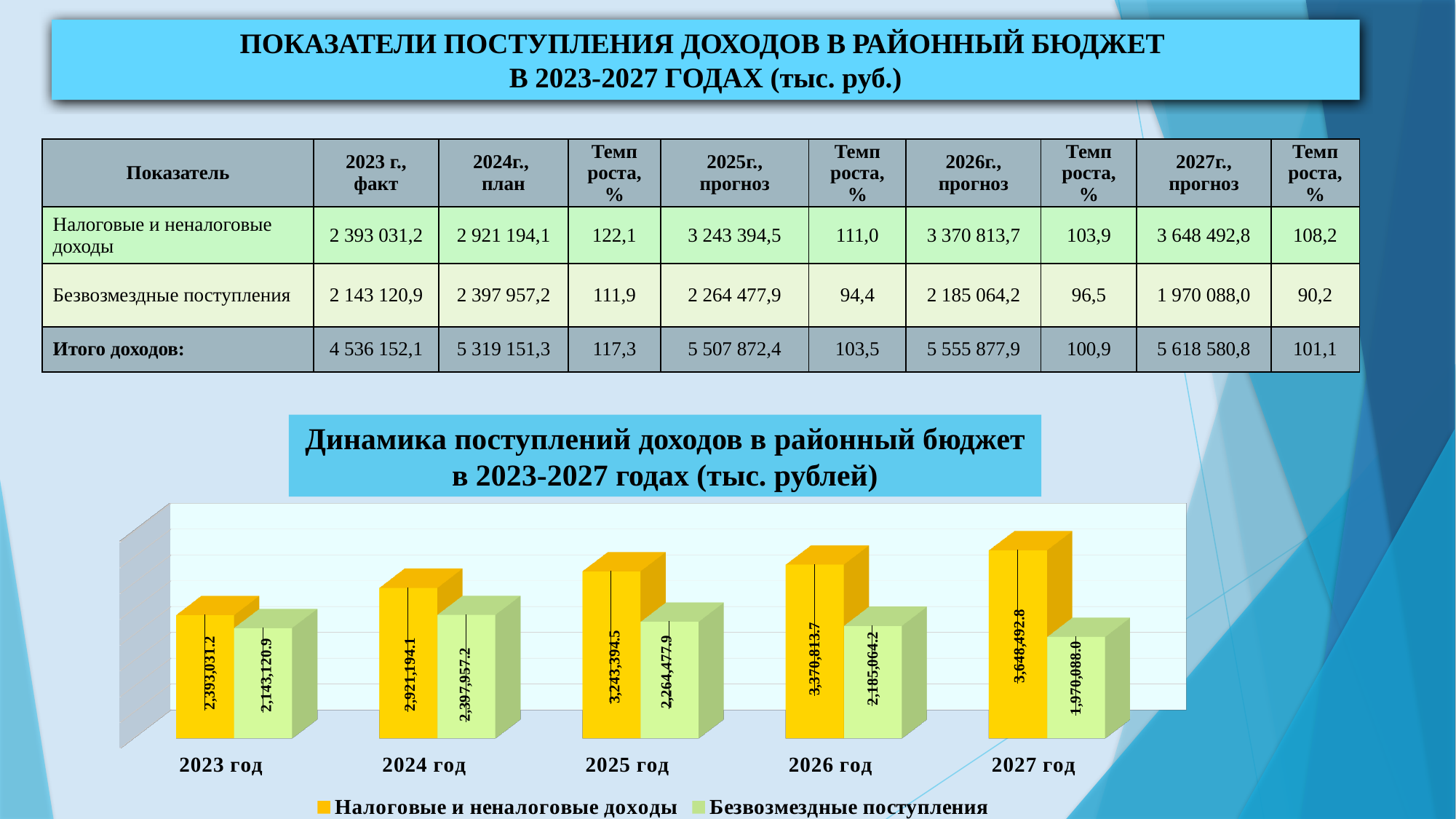
How many year categories are shown on the x axis of the chart? 5 How many series does the chart legend list? 2 What is the value of Безвозмездные поступления for 2027 год in the chart? 1,970,088.0 In which year is Налоговые и неналоговые доходы highest in the chart? 2027 год What kind of chart is shown on the slide? bar chart What colour are the bars for Безвозмездные поступления in the chart? light green What is the value of Безвозмездные поступления for 2025 год in the chart? 2,264,477.9 Which is larger in 2024 год: Налоговые и неналоговые доходы or Безвозмездные поступления? Налоговые и неналоговые доходы Do the values of Налоговые и неналоговые доходы rise or fall from 2023 год to 2027 год in the chart? rise In which year is Безвозмездные поступления lowest in the chart? 2027 год What is the value of Налоговые и неналоговые доходы for 2023 год in the chart? 2,393,031.2 What is the difference between Налоговые и неналоговые доходы and Безвозмездные поступления in 2026 год according to the chart? 1,185,749.5